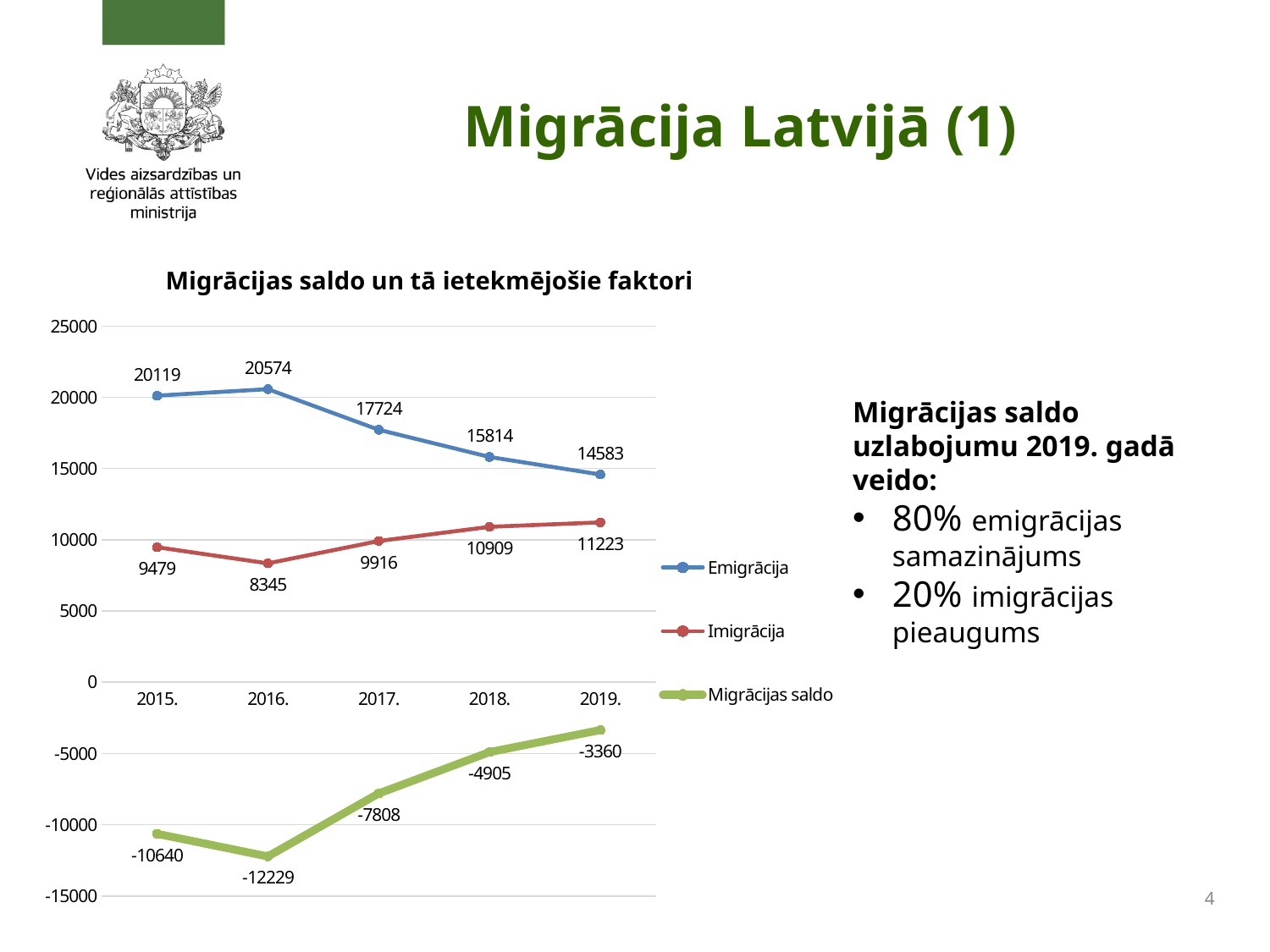
What is the value of Emigrācija in 2016.? 20574 In which year is Emigrācija highest? 2016. What is the value of Migrācijas saldo in 2017.? -7808 What is the difference between Emigrācija and Imigrācija in 2019.? 3360 Does Emigrācija rise or fall from 2016. to 2019.? fall In which year is Imigrācija lowest? 2016. What is the value of Imigrācija in 2019.? 11223 How many years are shown on the x axis? 5 What kind of chart is shown on the slide? line chart How many series does the legend list? 3 Is the value of Emigrācija in 2018. greater or less than 15000? greater Which is larger in 2015., Emigrācija or Imigrācija? Emigrācija